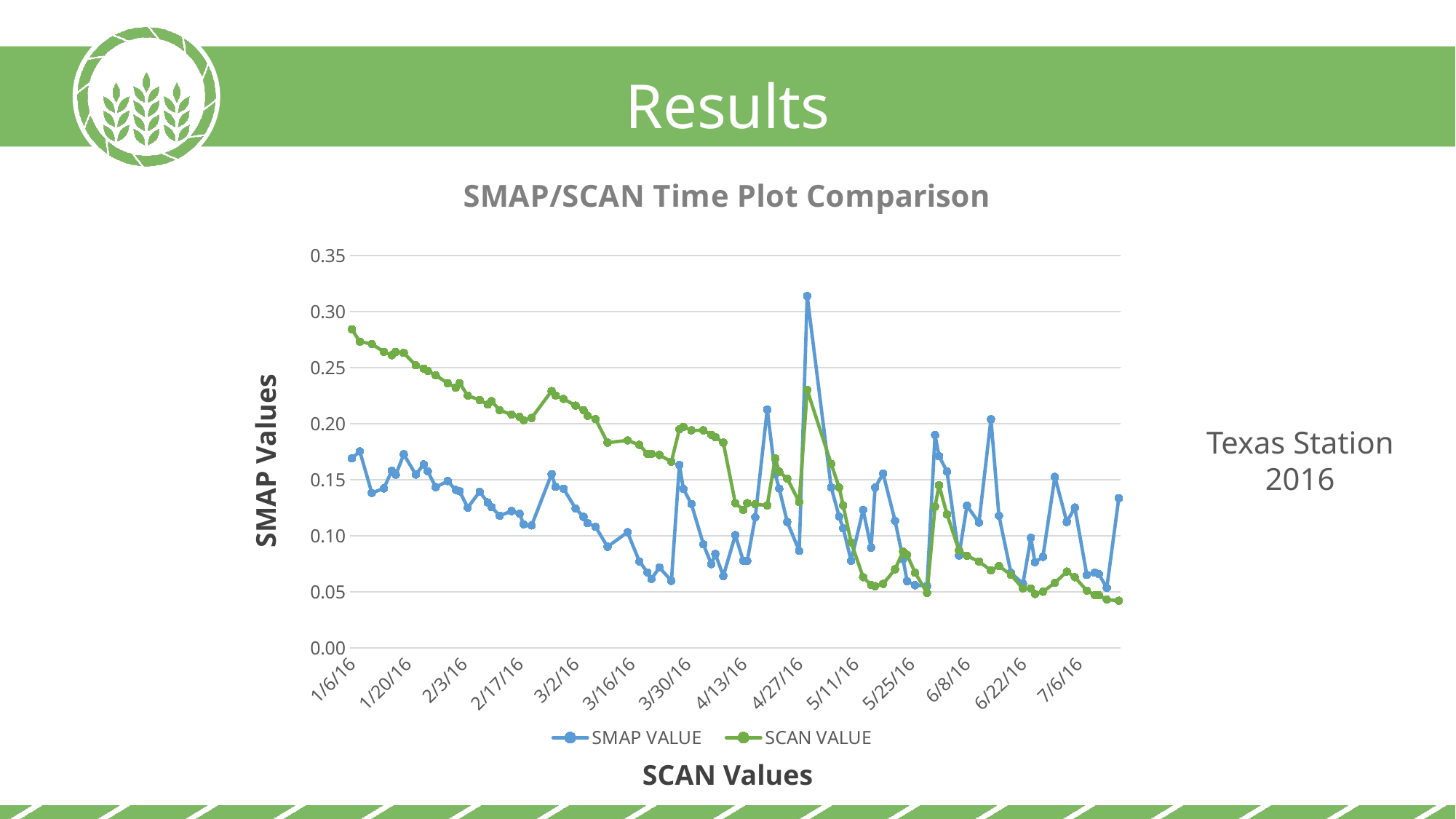
Does the SCAN VALUE series generally rise or fall from 1/6/16 to 7/6/16? fall How many series does the legend list? 2 At 1/6/16, which series has the higher value, SMAP VALUE or SCAN VALUE? SCAN VALUE Is the highest SMAP VALUE point on the chart greater or less than 0.30? greater Is the SCAN VALUE at the last plotted date greater or less than 0.05? less What kind of chart is shown on the slide? line chart Which series reaches the highest value anywhere on the chart? SMAP VALUE Which series is drawn in green? SCAN VALUE What is the title of the chart? SMAP/SCAN Time Plot Comparison Is the SMAP VALUE at 1/6/16 greater or less than 0.15? greater